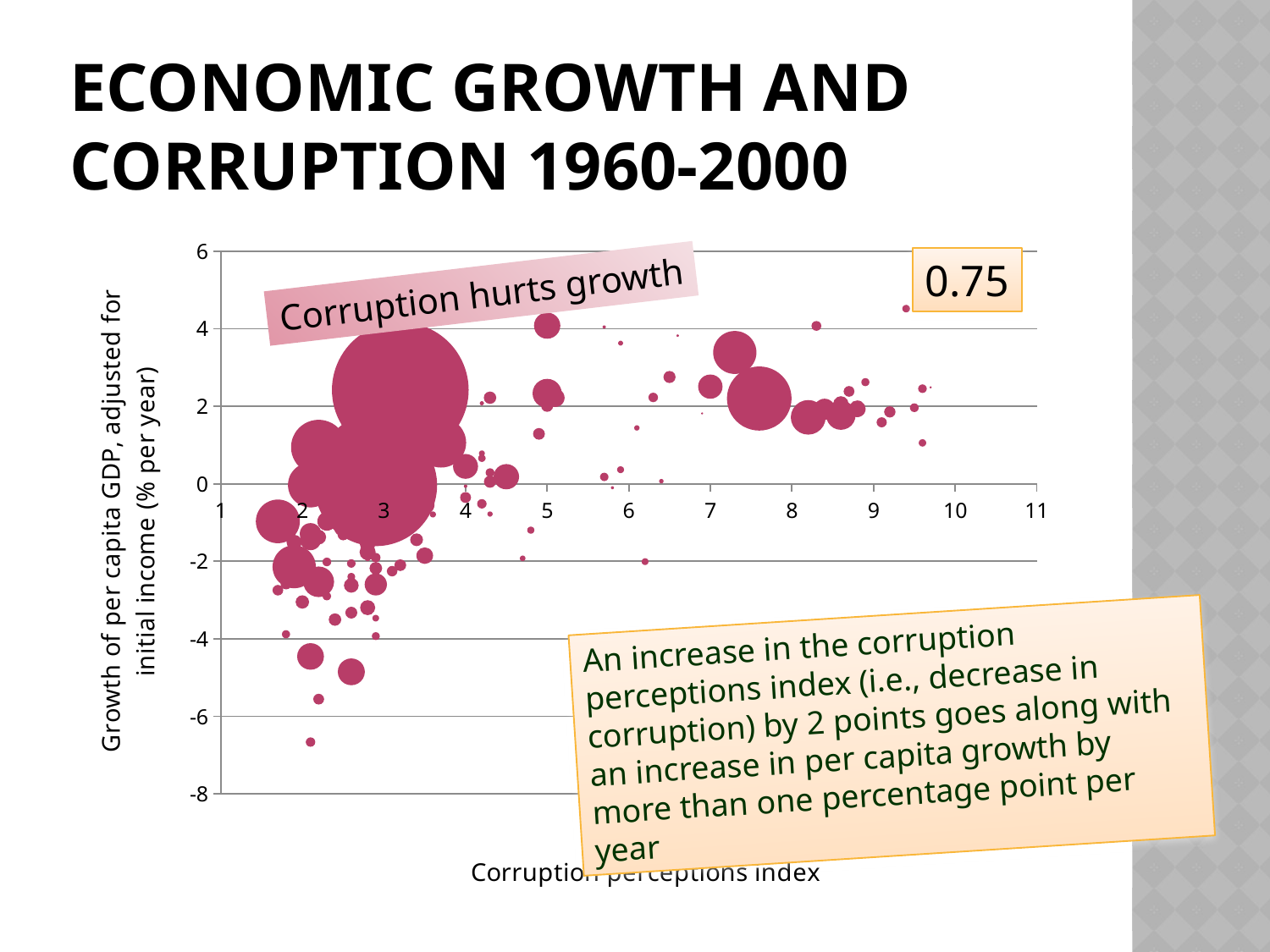
What kind of chart is shown on the slide? Bubble chart What text appears in the pink banner over the chart? Corruption hurts growth Is the lowest bubble on the chart above or below -6 on the growth axis? Below What is the title of the x axis? Corruption perceptions index As the corruption perceptions index increases along the x axis, do the growth values generally rise or fall? Rise Are the bubbles with a corruption perceptions index above 7 mostly above or below 0 on the growth axis? Above